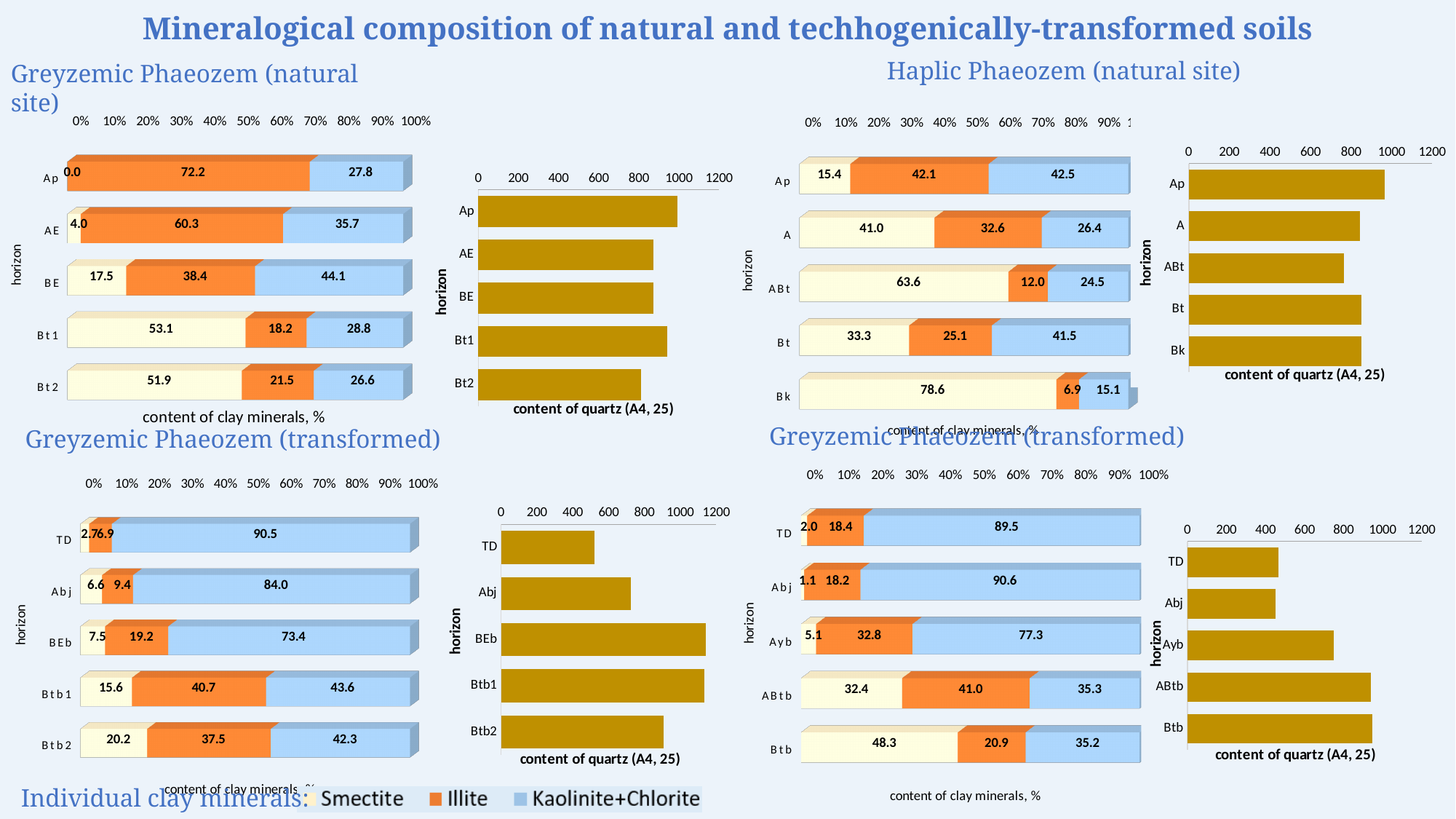
In the bottom-left Greyzemic Phaeozem (transformed) clay minerals chart, what is the difference between the Kaolinite+Chlorite values of TD and Btb2? 48.2 In the bottom-right Greyzemic Phaeozem (transformed) clay minerals chart, which is larger: the Illite value for ABtb or for Btb? ABtb How many horizons are shown in the Haplic Phaeozem (natural site) clay minerals chart? 5 In the Haplic Phaeozem (natural site) clay minerals chart, what is the Smectite value for the Bk horizon? 78.6 In the top-left content of quartz chart for Greyzemic Phaeozem (natural site), is the value for Ap greater or less than 800? greater In the bottom-left content of quartz chart for Greyzemic Phaeozem (transformed), is the value for TD greater or less than 600? less In the Haplic Phaeozem (natural site) clay minerals chart, which horizon has the lowest Illite value? Bk In the Greyzemic Phaeozem (natural site) clay minerals chart at the top left, which horizon has the highest Kaolinite+Chlorite value? BE How many series does the legend for the clay minerals charts list? 3 In the Greyzemic Phaeozem (natural site) clay minerals chart at the top left, what is the Illite value for the Ap horizon? 72.2 What kind of chart is the content of quartz chart next to the Haplic Phaeozem (natural site) chart? bar chart